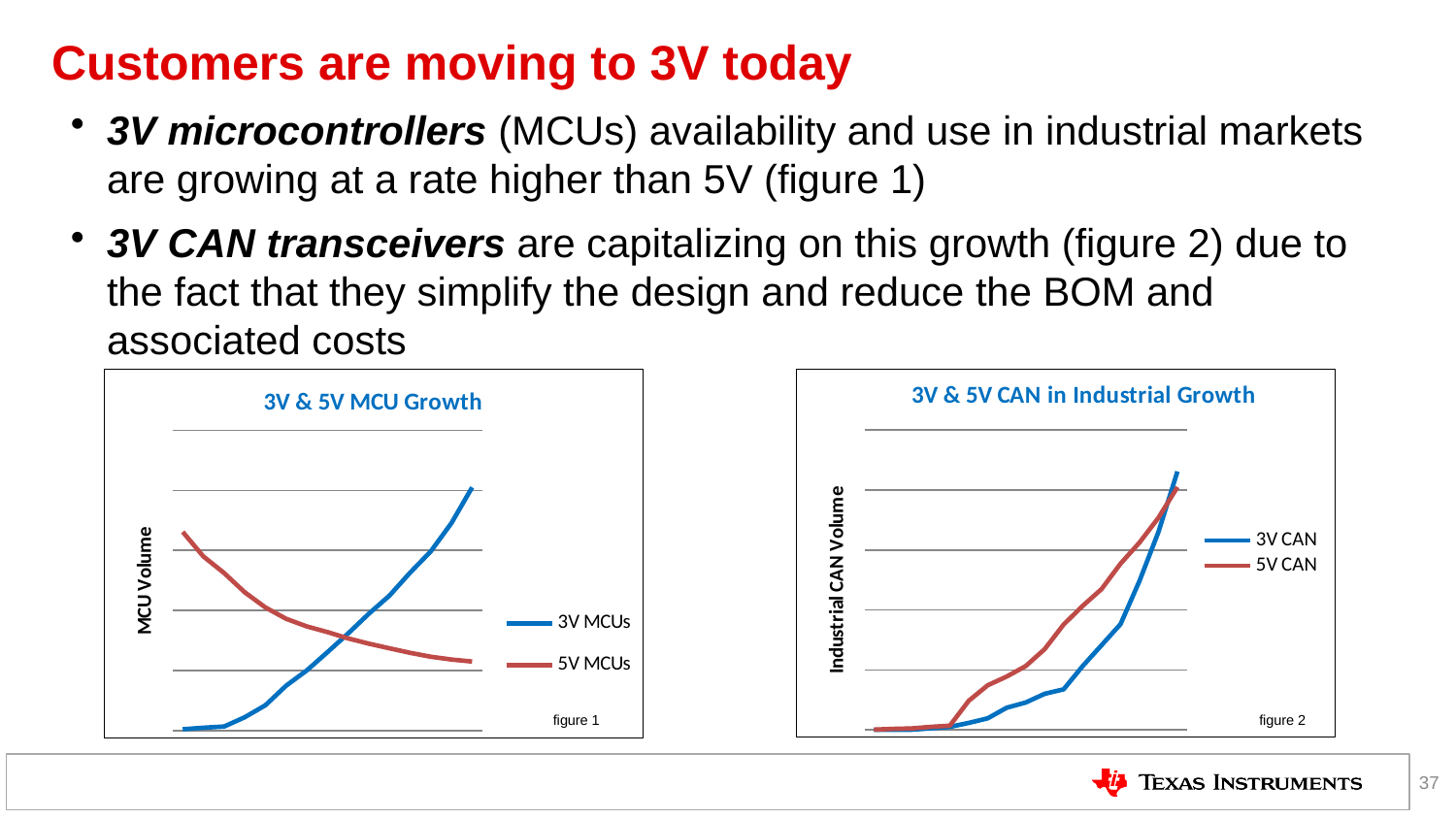
How many series does the legend of the "3V & 5V MCU Growth" chart list? 2 What kind of chart is the "3V & 5V MCU Growth" chart? Line chart In the "3V & 5V MCU Growth" chart, what colour is the 5V MCUs line? Red In the "3V & 5V MCU Growth" chart, does the 5V MCUs line rise or fall along the x axis? Falls What is the y-axis label of the "3V & 5V CAN in Industrial Growth" chart? Industrial CAN Volume In the "3V & 5V CAN in Industrial Growth" chart, does the 3V CAN line rise or fall along the x axis? Rises In the "3V & 5V CAN in Industrial Growth" chart, does the 5V CAN line rise or fall along the x axis? Rises In the "3V & 5V MCU Growth" chart, which series is higher at the right end of the x axis, 3V MCUs or 5V MCUs? 3V MCUs How many series does the legend of the "3V & 5V CAN in Industrial Growth" chart list? 2 In the "3V & 5V MCU Growth" chart, which series is higher at the left end of the x axis, 3V MCUs or 5V MCUs? 5V MCUs What kind of chart is the "3V & 5V CAN in Industrial Growth" chart? Line chart